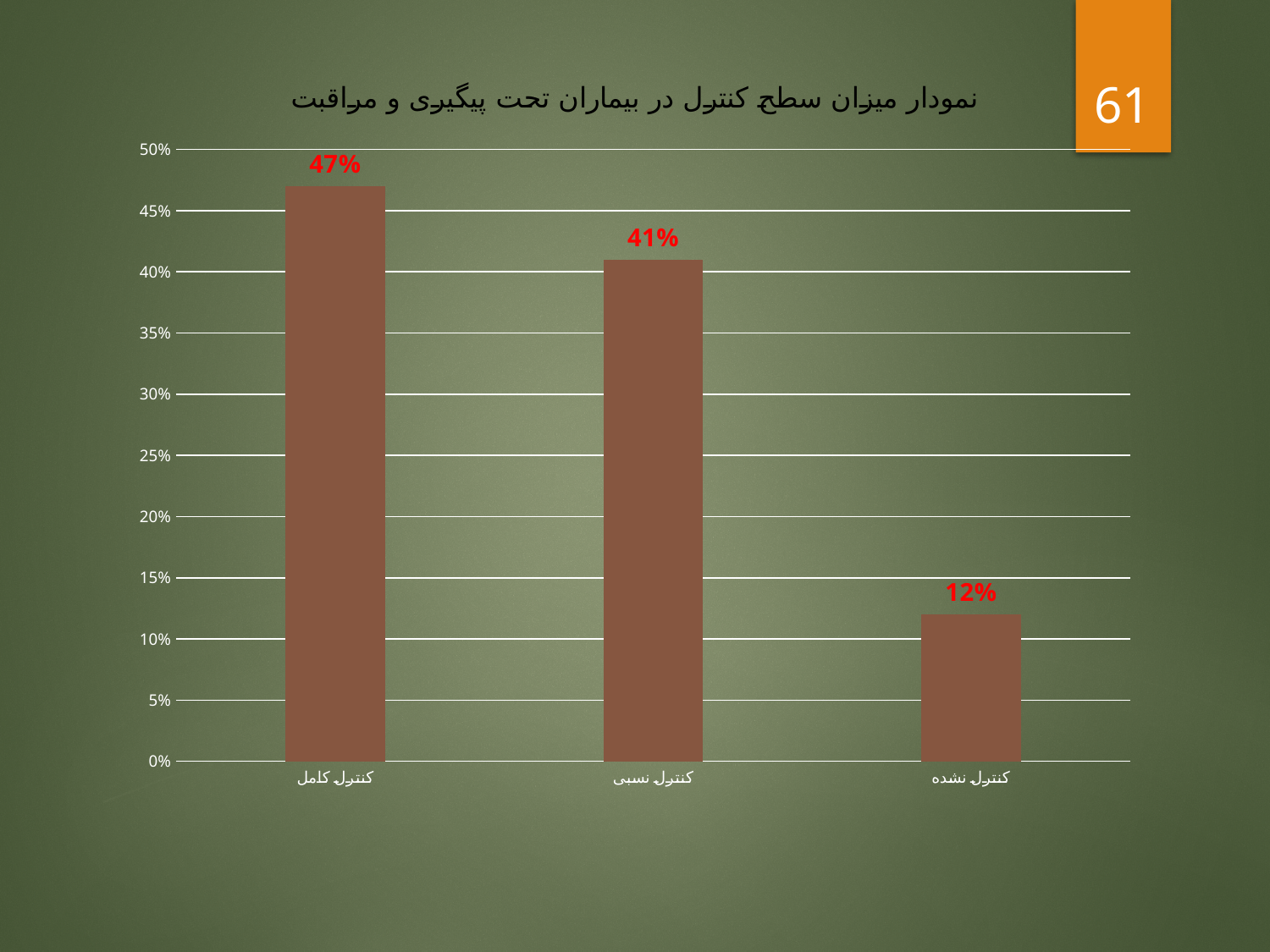
Which category has the lowest value? کنترل نشده What is the difference between the values for کنترل نسبی and کنترل نشده? 29% What is the title of the chart? نمودار میزان سطح کنترل در بیماران تحت پیگیری و مراقبت What is the value for کنترل کامل? 47% Is the value for کنترل نشده greater or less than 15%? less Which category has the highest value? کنترل کامل What is the value for کنترل نسبی? 41% How many categories are shown on the x axis? 3 What is the value for کنترل نشده? 12% What is the difference between the values for کنترل کامل and کنترل نسبی? 6% What kind of chart is shown on the slide? bar chart Which is larger, the value for کنترل نسبی or the value for کنترل نشده? کنترل نسبی